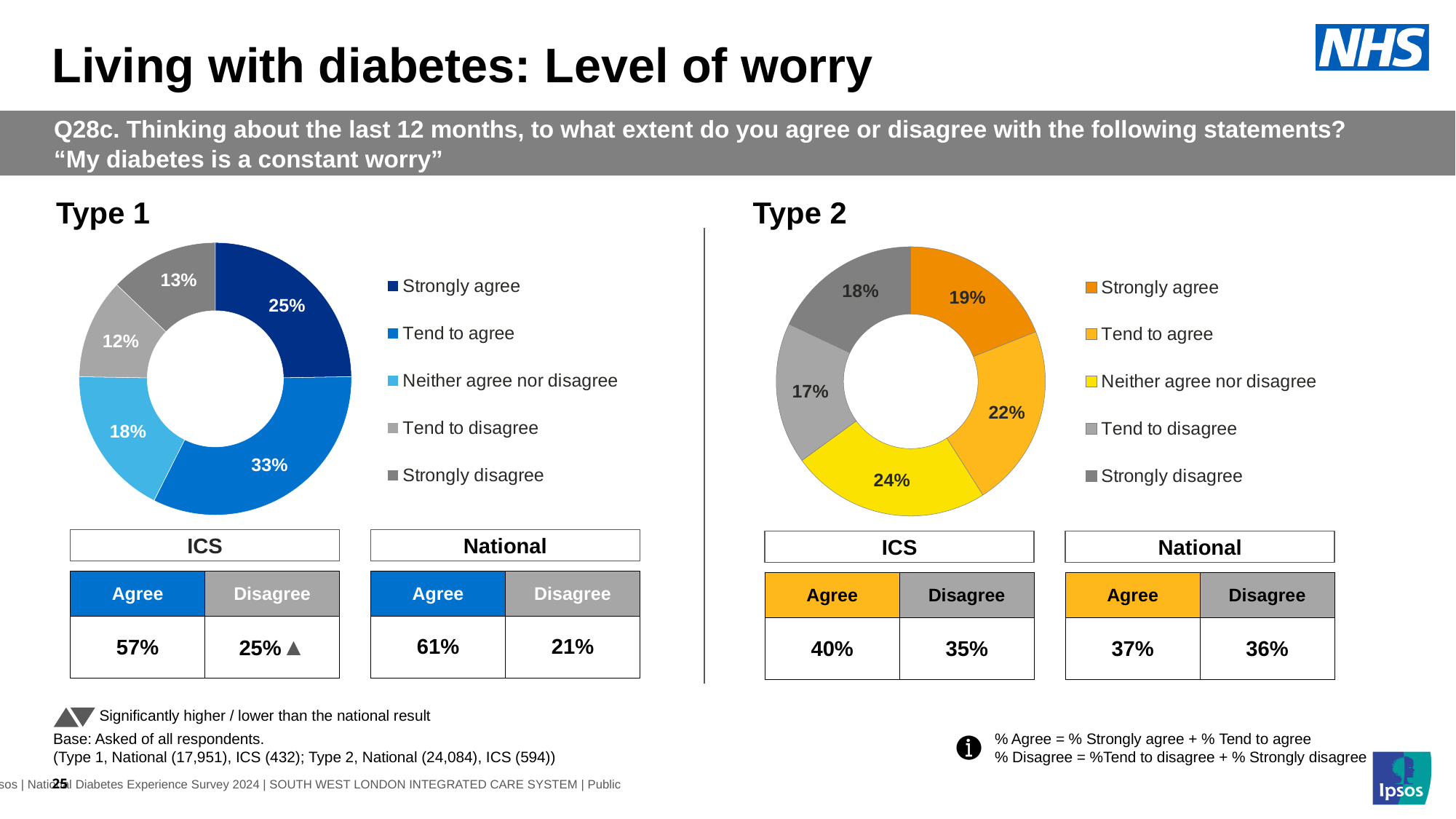
In the Type 1 chart, what is the difference in percentage points between Tend to agree and Strongly agree? 8 What kind of chart is used for Type 1? Donut chart In the Type 1 chart, what percentage of respondents said they tend to agree? 33% In the Type 2 chart, which is larger: Strongly agree or Tend to agree? Tend to agree In the Type 2 chart, what percentage of respondents said they tend to disagree? 17% In the Type 1 chart, which response category has the largest share? Tend to agree In the Type 2 chart, what percentage of respondents said they neither agree nor disagree? 24% In the Type 2 chart, which response category has the largest share? Neither agree nor disagree In the Type 1 chart, what percentage of respondents said they strongly disagree? 13% In the Type 1 chart, which response category has the smallest share? Tend to disagree In the Type 2 chart, what colour represents Strongly agree? Orange How many response categories are shown in the Type 2 chart? 5